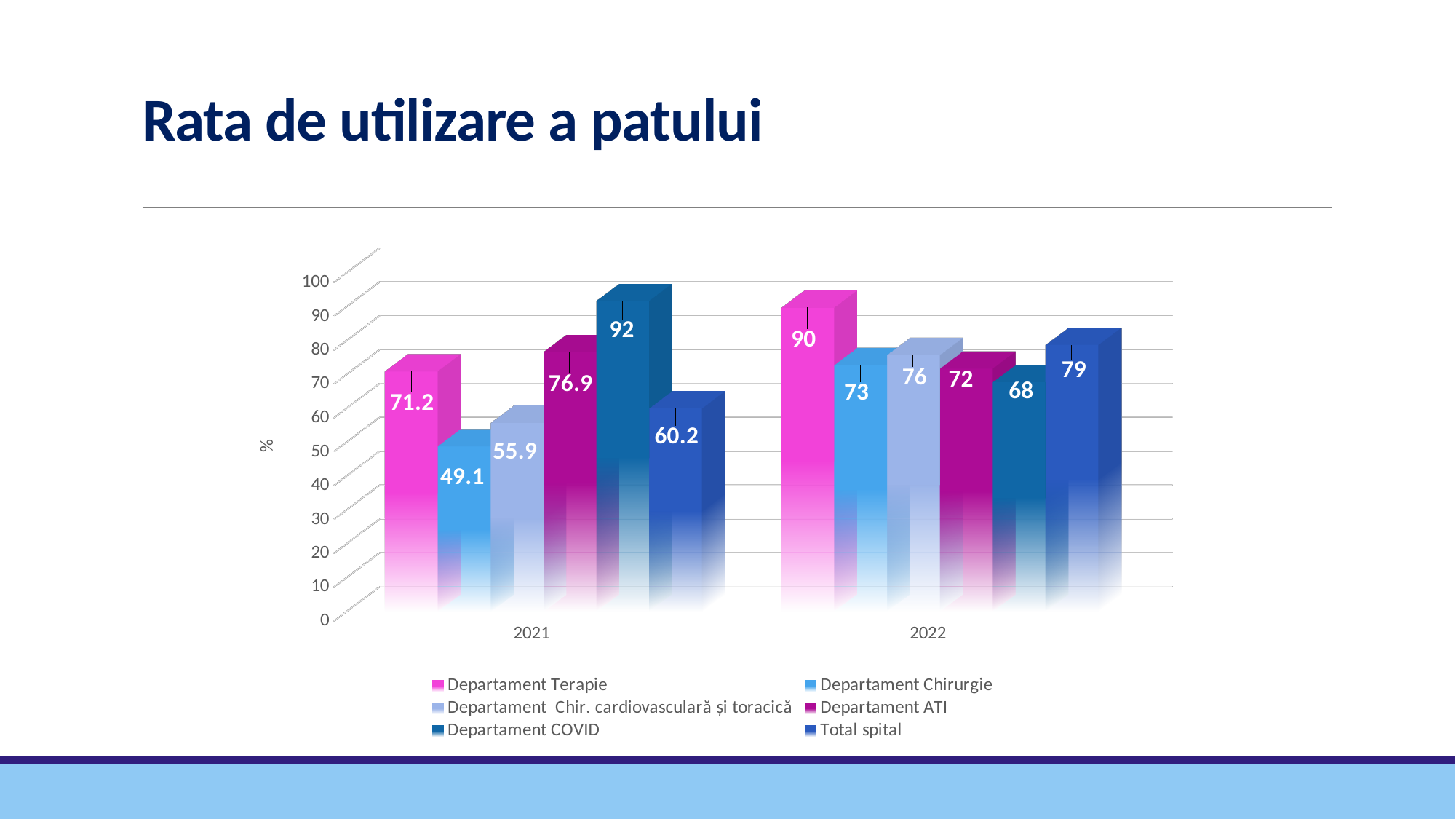
What kind of chart is shown on the slide? Bar chart Which department has the lowest value in 2022? Departament COVID Which department has the highest value in 2021? Departament COVID What is the difference between the Departament Terapie values for 2022 and 2021? 18.8 How many year categories are shown on the x axis? 2 What is the value for Total spital in 2021? 60.2 What is the value for Departament COVID in 2021? 92 What is the value for Departament Chirurgie in 2021? 49.1 How many series does the legend list? 6 Which is larger: Departament ATI in 2021 or Departament ATI in 2022? Departament ATI in 2021 What is the title of the slide? Rata de utilizare a patului What is the value for Departament Terapie in 2022? 90